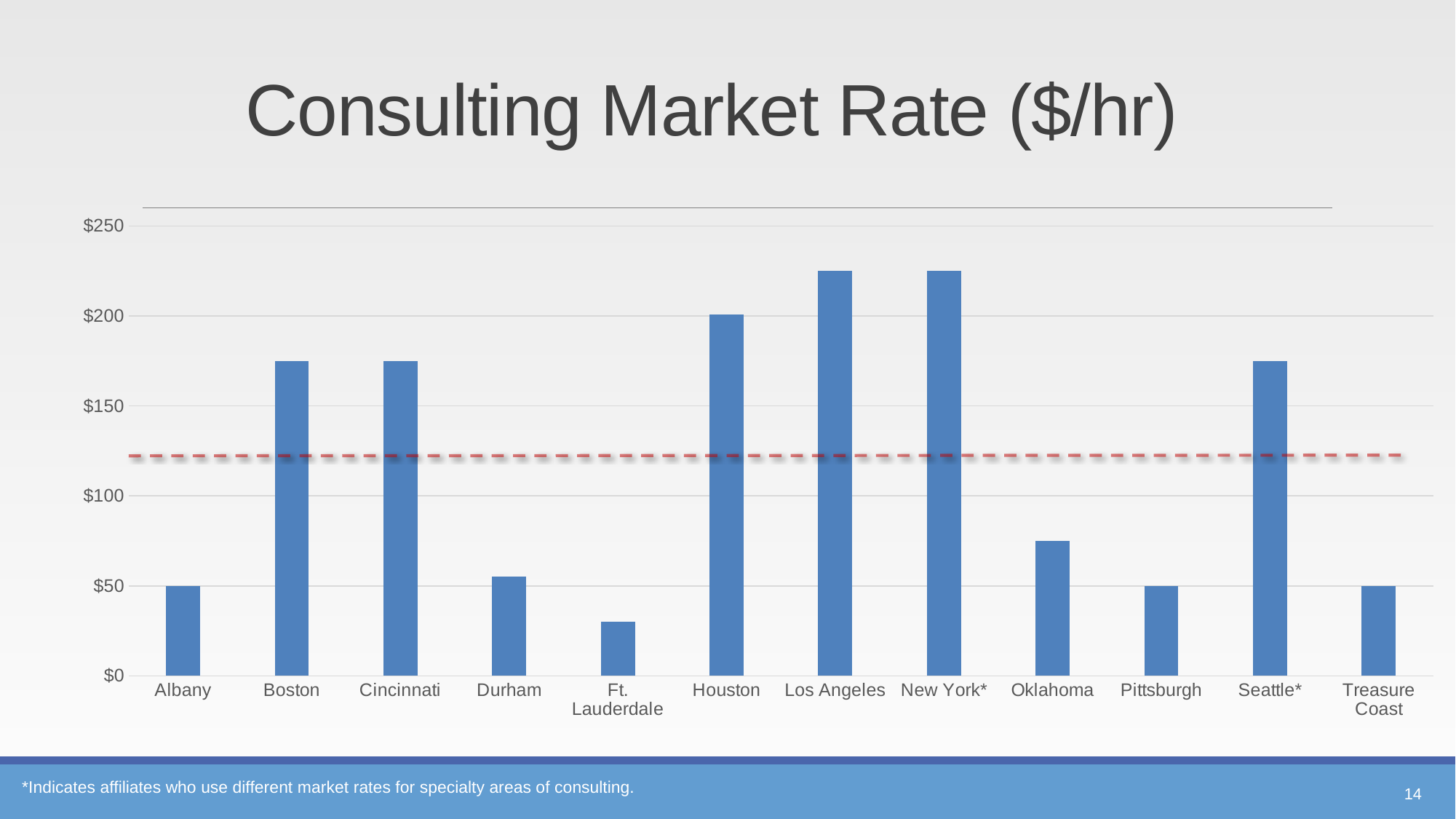
What is the consulting market rate for Pittsburgh? $50 How many cities are shown on the x axis of the chart? 12 Is the value for Boston greater or less than $150? greater According to the footnote, what does the asterisk after a city name indicate? Affiliates who use different market rates for specialty areas of consulting Is the value for Oklahoma greater or less than $100? less Which has a higher consulting market rate, Houston or Oklahoma? Houston What is the consulting market rate for Treasure Coast? $50 What is the consulting market rate for Albany? $50 Which city has the lowest consulting market rate? Ft. Lauderdale What kind of chart is shown on the slide? bar chart Which has a higher consulting market rate, Durham or Cincinnati? Cincinnati Is the value for Ft. Lauderdale greater or less than $50? less